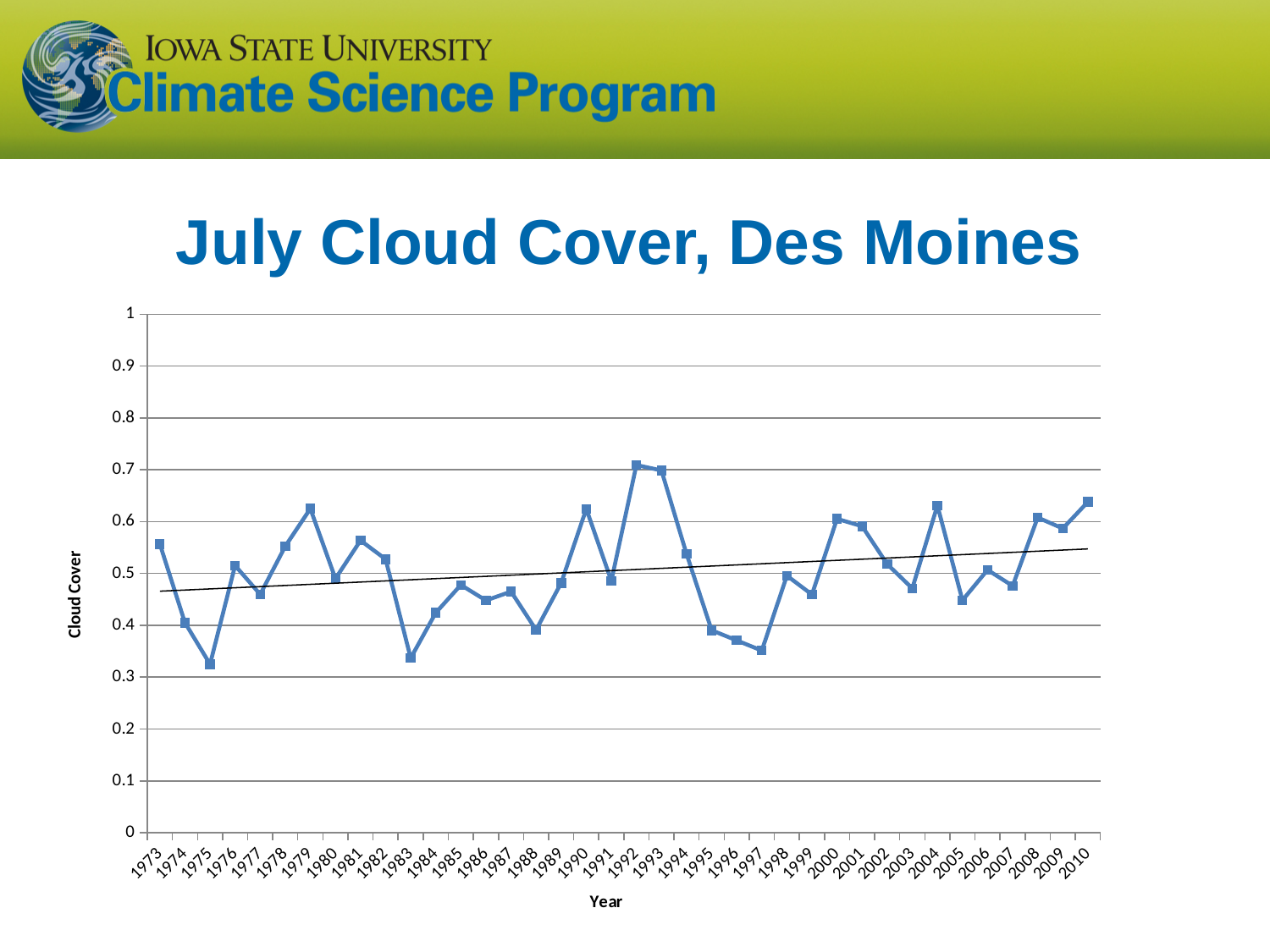
Which year has the highest July cloud cover? 1992 How many years are plotted on the x axis? 38 Which year has the larger cloud cover value, 1979 or 1983? 1979 What kind of chart is shown on the slide? Line chart Is the value for 1975 greater or less than 0.4? less Does the straight trend line rise or fall from 1973 to 2010? Rises Is the value for 1992 greater or less than 0.6? greater Is the value for 1997 greater or less than 0.4? less What is the label on the vertical axis? Cloud Cover What is the title of the chart? July Cloud Cover, Des Moines